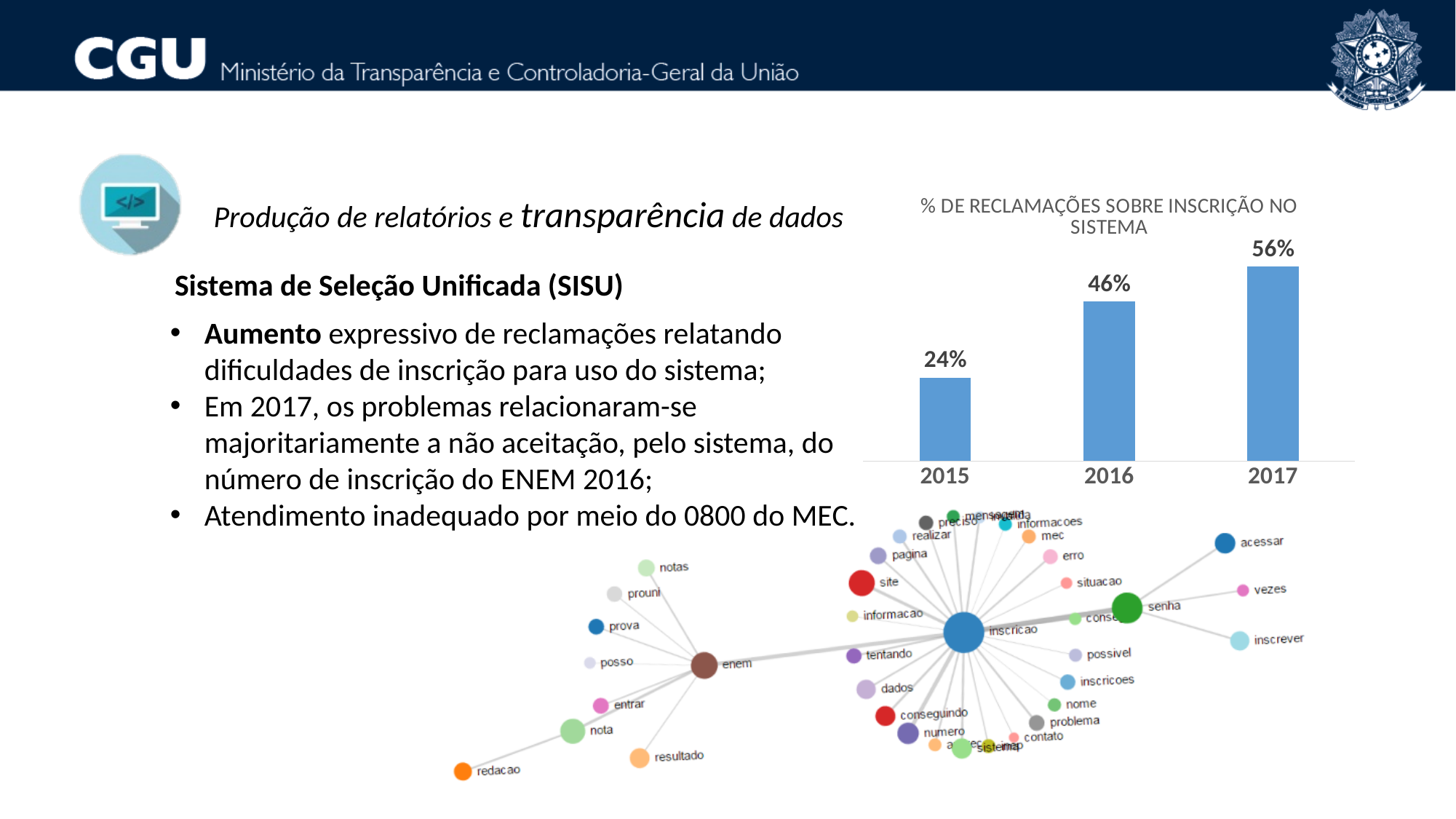
In the chart titled "% DE RECLAMAÇÕES SOBRE INSCRIÇÃO NO SISTEMA", what is the value for 2015? 24% What is the title of the bar chart on the right side of the slide? % DE RECLAMAÇÕES SOBRE INSCRIÇÃO NO SISTEMA In the chart titled "% DE RECLAMAÇÕES SOBRE INSCRIÇÃO NO SISTEMA", which year has the lowest value? 2015 In the chart titled "% DE RECLAMAÇÕES SOBRE INSCRIÇÃO NO SISTEMA", do the values rise or fall from 2015 to 2017? Rise In the chart titled "% DE RECLAMAÇÕES SOBRE INSCRIÇÃO NO SISTEMA", what is the value for 2017? 56% In the chart titled "% DE RECLAMAÇÕES SOBRE INSCRIÇÃO NO SISTEMA", which is larger, the value for 2016 or the value for 2017? 2017 In the chart titled "% DE RECLAMAÇÕES SOBRE INSCRIÇÃO NO SISTEMA", what is the value for 2016? 46% In the chart titled "% DE RECLAMAÇÕES SOBRE INSCRIÇÃO NO SISTEMA", which year has the highest value? 2017 How many bars are shown in the chart titled "% DE RECLAMAÇÕES SOBRE INSCRIÇÃO NO SISTEMA"? 3 In the chart titled "% DE RECLAMAÇÕES SOBRE INSCRIÇÃO NO SISTEMA", what is the difference between the values for 2016 and 2015? 22% In the chart titled "% DE RECLAMAÇÕES SOBRE INSCRIÇÃO NO SISTEMA", what is the difference between the values for 2017 and 2015? 32% What kind of chart is the one titled "% DE RECLAMAÇÕES SOBRE INSCRIÇÃO NO SISTEMA"? Bar chart